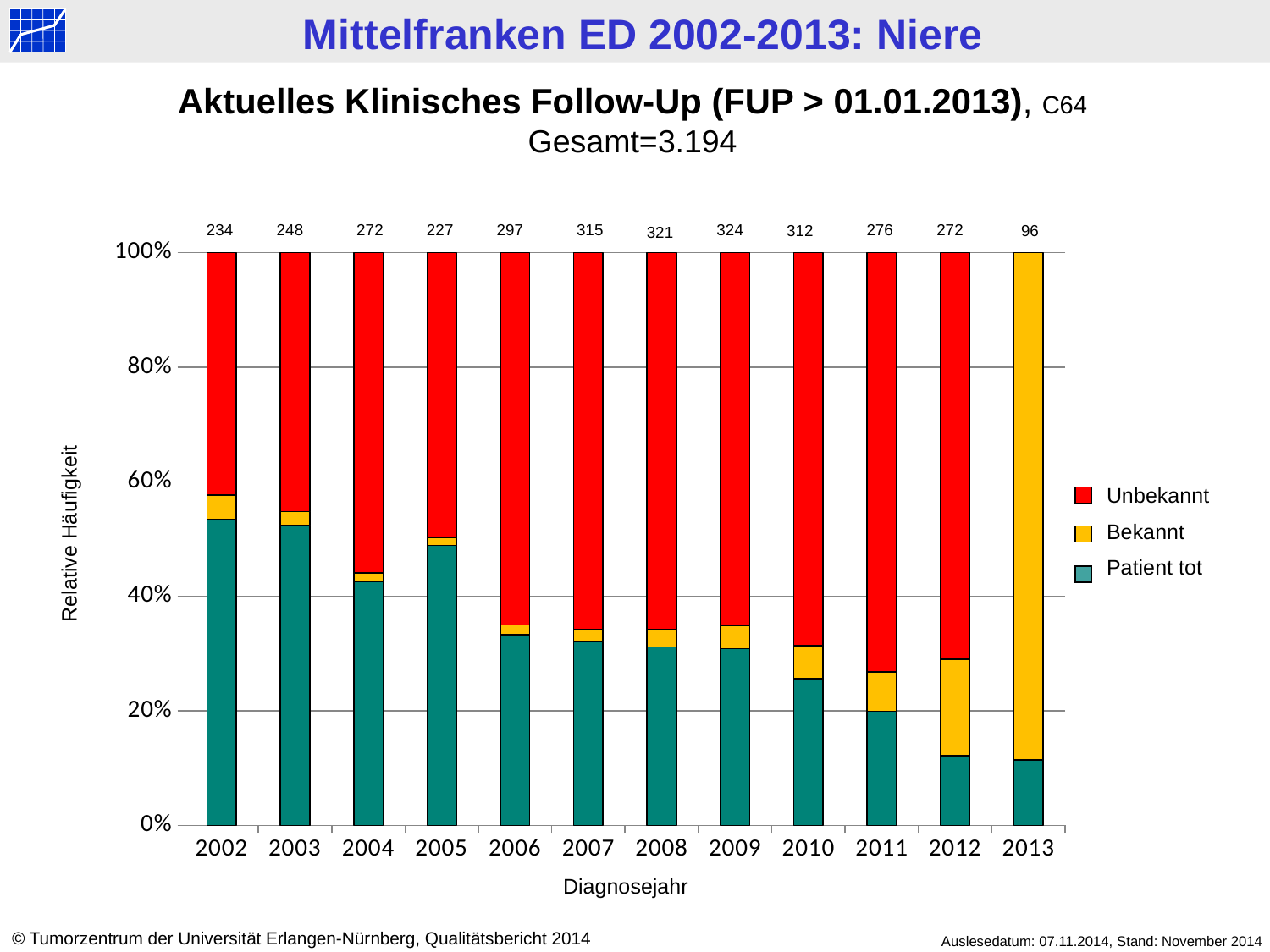
What is the difference between the numbers printed above the bars for 2008 and 2002? 87 Which year has the lowest number printed above its bar? 2013 What number is printed above the bar for 2009? 324 How many diagnosis years are shown on the x axis? 12 What kind of chart is shown on the slide? Stacked bar chart Which year has a larger number printed above its bar, 2004 or 2005? 2004 What number is printed above the bar for 2013? 96 Is the 'Patient tot' share for 2002 greater or less than 40%? greater Does the 'Patient tot' share generally rise or fall from 2002 to 2013? fall How many series does the legend list? 3 Which year has the highest number printed above its bar? 2009 Is the 'Patient tot' share for 2011 greater or less than 40%? less